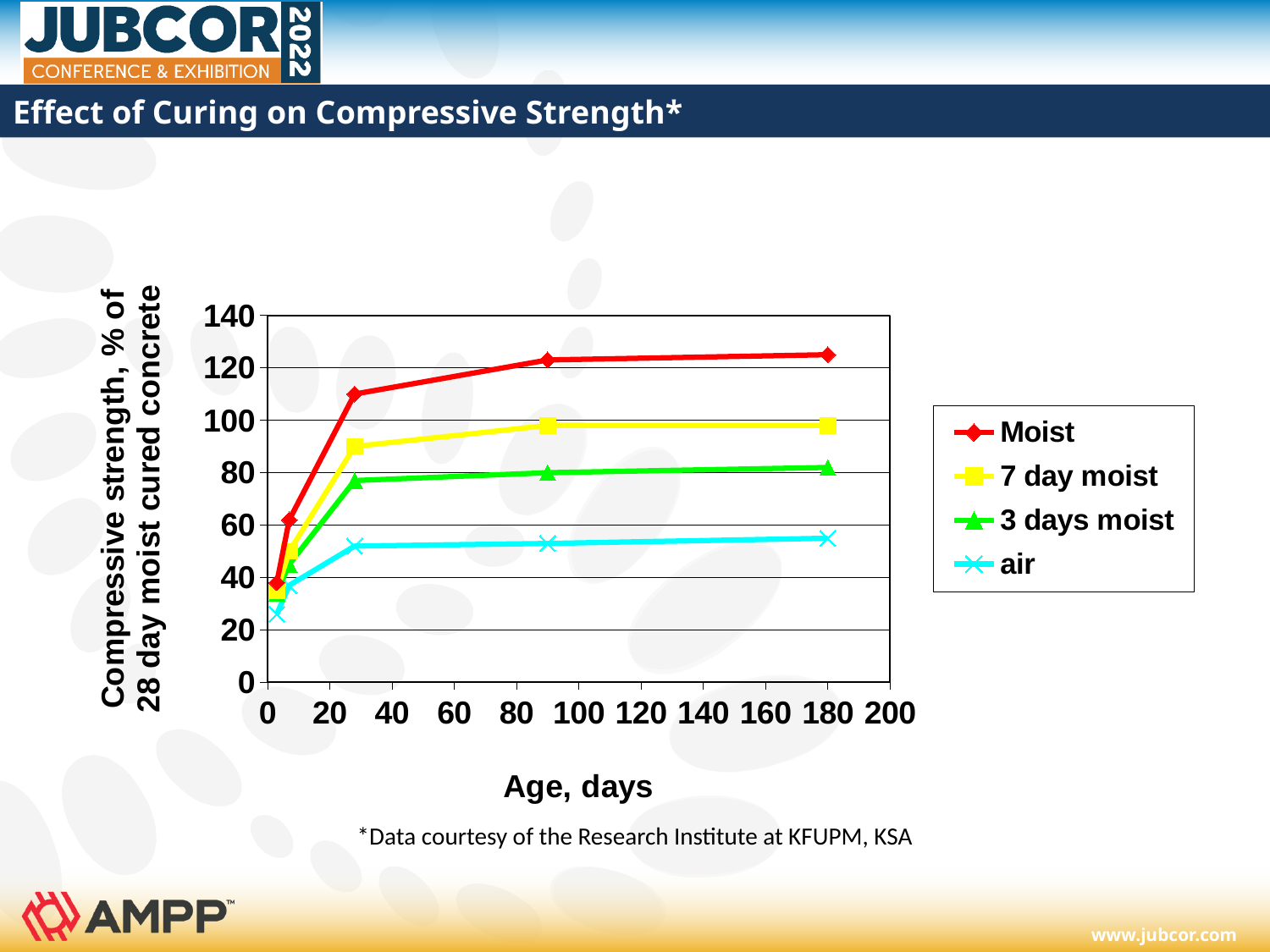
What kind of chart is shown on the slide? line chart How many series does the legend list? 4 Is the value for Moist at 180 days greater or less than 120? greater Which series has the highest compressive strength at 180 days? Moist At 90 days, which is larger: 7 day moist or 3 days moist? 7 day moist Is the value for air at 180 days greater or less than 80? less Does the compressive strength for the Moist series rise or fall as age increases? rise Is the value for Moist at 28 days greater or less than 100? greater Which series has the lowest compressive strength at 180 days? air What is the title of the x axis? Age, days How many data points are plotted for the Moist series? 5